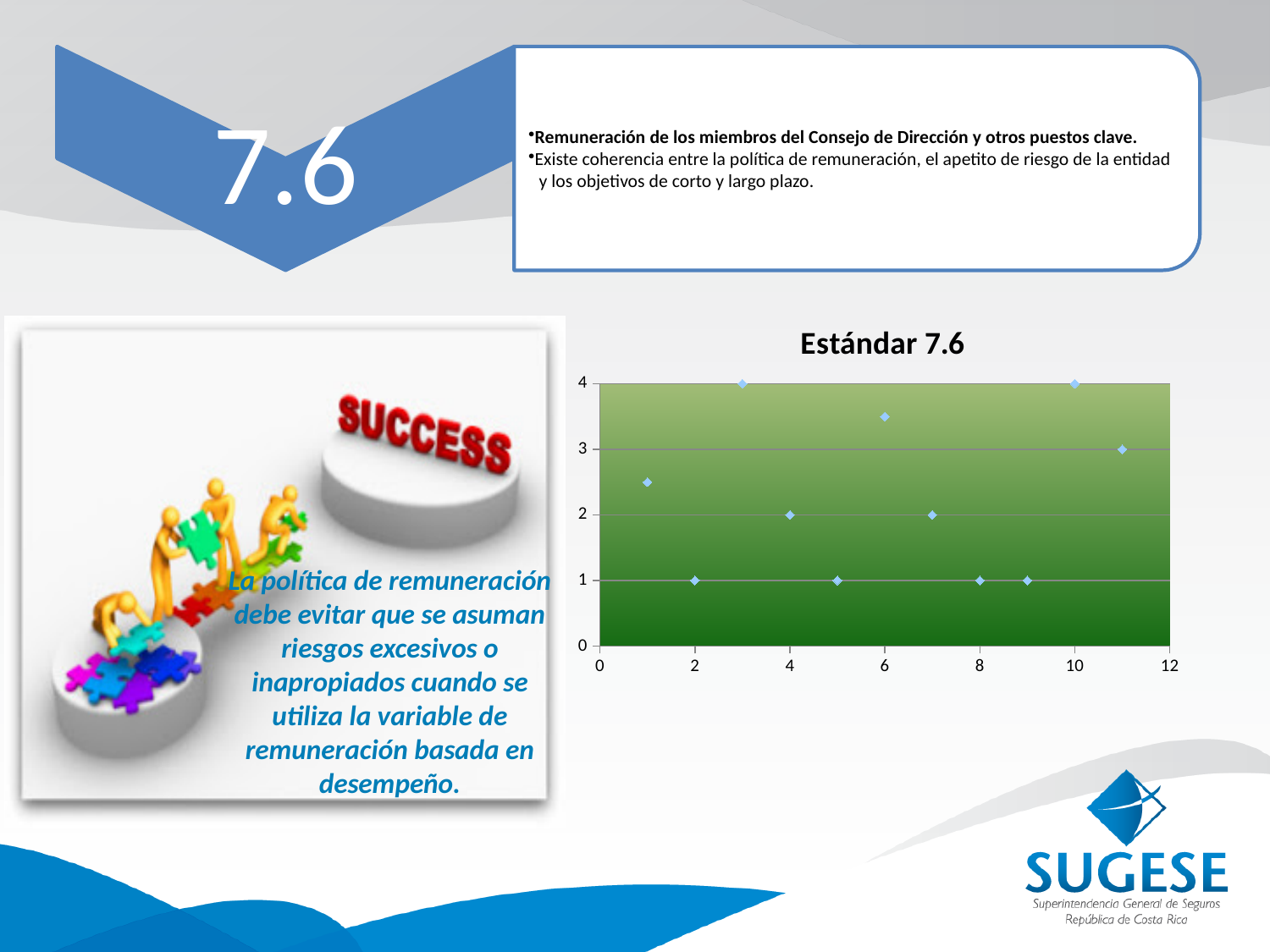
What is the highest value shown on the y axis of the Estándar 7.6 chart? 4 What is the y value of the point at x = 11 in the Estándar 7.6 chart? 3 Is the y value of the point at x = 6 greater or less than 3? greater What is the y value of the point at x = 8 in the Estándar 7.6 chart? 1 What is the difference between the y values of the points at x = 10 and x = 11? 1 What is the y value of the point at x = 3 in the Estándar 7.6 chart? 4 Is the y value of the point at x = 1 greater or less than 2? greater What is the title of the chart? Estándar 7.6 What is the y value of the point at x = 4 in the Estándar 7.6 chart? 2 How many data points are plotted in the Estándar 7.6 chart? 11 What kind of chart is shown under the title Estándar 7.6? scatter chart Which point has the larger y value, the one at x = 3 or the one at x = 11? x = 3